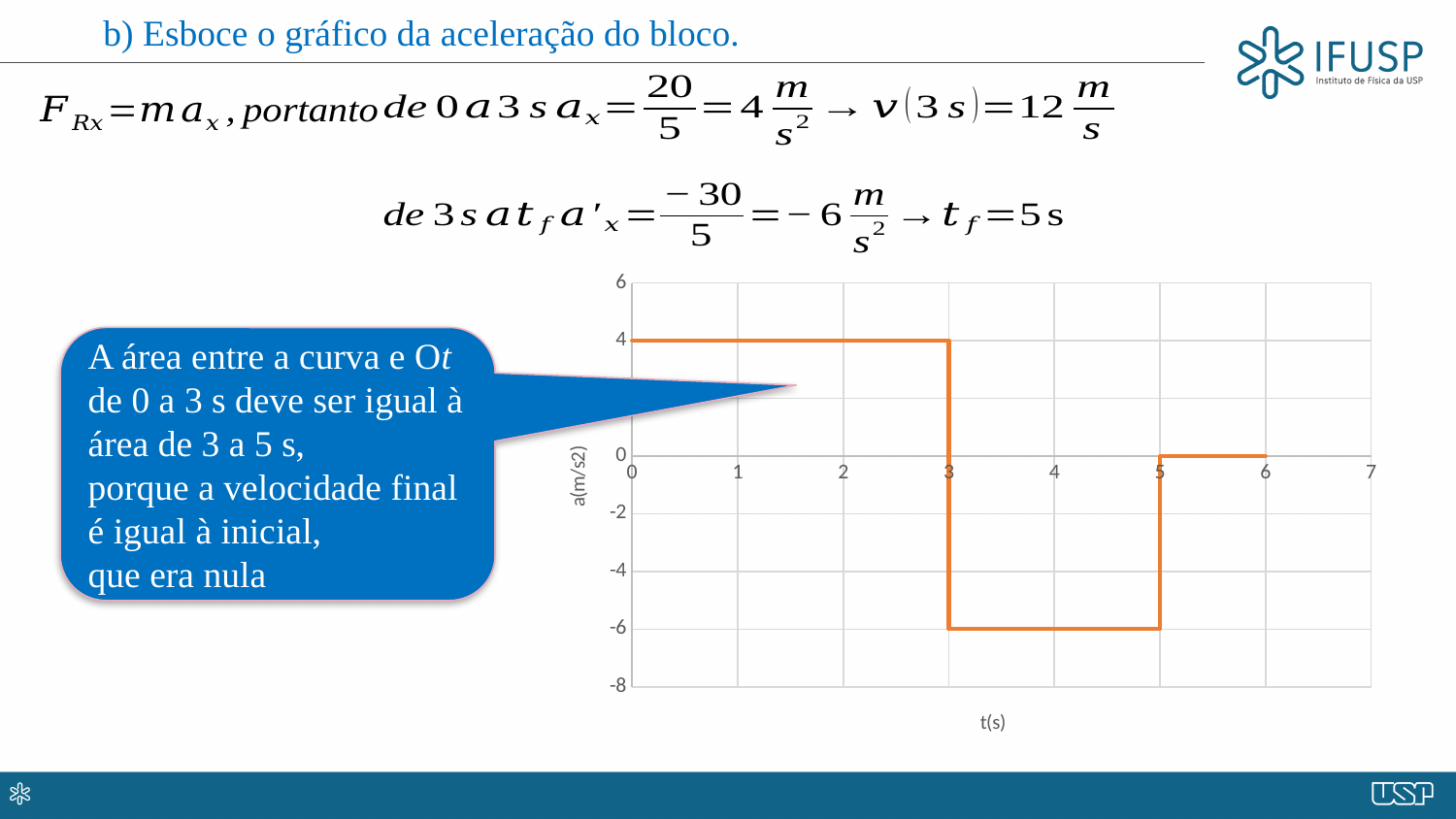
What kind of chart is shown on the slide? line chart What is the difference between the acceleration value from 0 to 3 s and the value from 3 to 5 s? 10 What is the highest value shown on the vertical axis of the chart? 6 What is the label of the horizontal axis of the chart? t(s) Which is larger: the acceleration value between 0 and 3 s or the value between 3 and 5 s? between 0 and 3 s What is the label of the vertical axis of the chart? a(m/s2) Does the acceleration rise or fall at t = 3 s? fall What is the value of the acceleration between t = 3 s and t = 5 s? -6 What is the value of the acceleration between t = 5 s and t = 6 s? 0 Is the acceleration value between 3 s and 5 s greater or less than -4? less What is the value of the acceleration between t = 0 and t = 3 s? 4 Is the acceleration value between 0 and 3 s greater or less than 2? greater